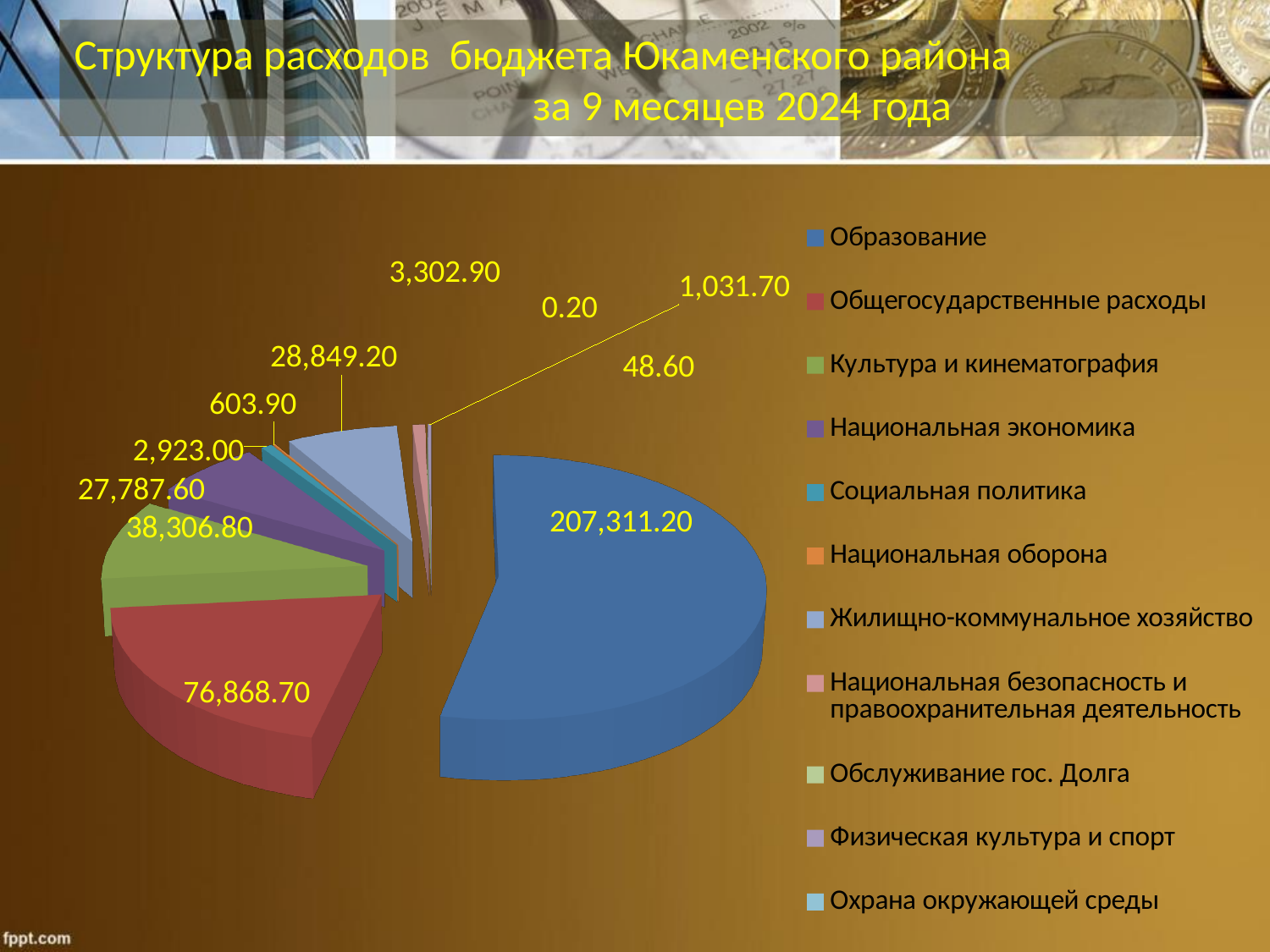
What is the value shown for Образование? 207,311.20 What is the title of the slide? Структура расходов бюджета Юкаменского района за 9 месяцев 2024 года What is the value shown for Общегосударственные расходы? 76,868.70 What is the value shown for Жилищно-коммунальное хозяйство? 28,849.20 How many categories does the legend list? 11 What is the value shown for Культура и кинематография? 38,306.80 What is the value shown for Национальная экономика? 27,787.60 What is the smallest value labelled on the pie chart? 0.20 Which is larger, the value for Образование or the value for Общегосударственные расходы? Образование What kind of chart is shown on the slide? pie chart Which category has the largest slice of the pie? Образование What is the difference between the values for Образование and Общегосударственные расходы? 130,442.50